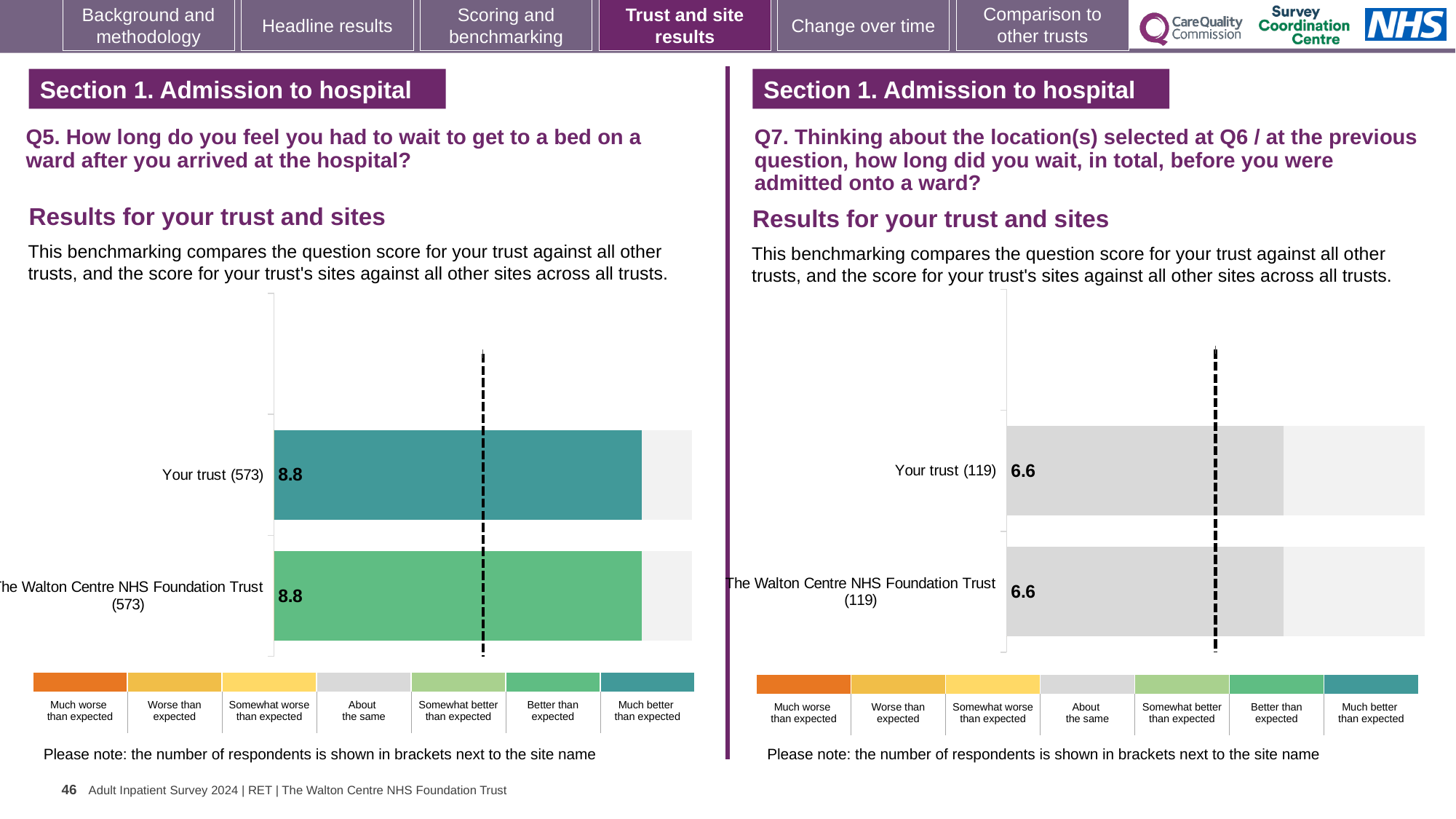
In the Q5 chart on the left, what is the score for Your trust? 8.8 Is the score for Your trust in the Q7 chart on the right greater or less than the score for Your trust in the Q5 chart on the left? less How many bars are plotted in the Q5 chart on the left? 2 In the Q7 chart on the right, what is the score for Your trust? 6.6 In the Q5 chart on the left, what is the difference between the score for Your trust and the score for The Walton Centre NHS Foundation Trust? 0 In the Q7 chart on the right, what is the difference between the score for Your trust and the score for The Walton Centre NHS Foundation Trust? 0 In the Q5 chart on the left, how many respondents are shown in brackets next to Your trust? 573 How many bars are plotted in the Q7 chart on the right? 2 What kind of chart is the Q5 chart on the left? Bar chart In the Q7 chart on the right, what is the score for The Walton Centre NHS Foundation Trust? 6.6 In the Q5 chart on the left, what is the score for The Walton Centre NHS Foundation Trust? 8.8 In the Q7 chart on the right, how many respondents are shown in brackets next to The Walton Centre NHS Foundation Trust? 119